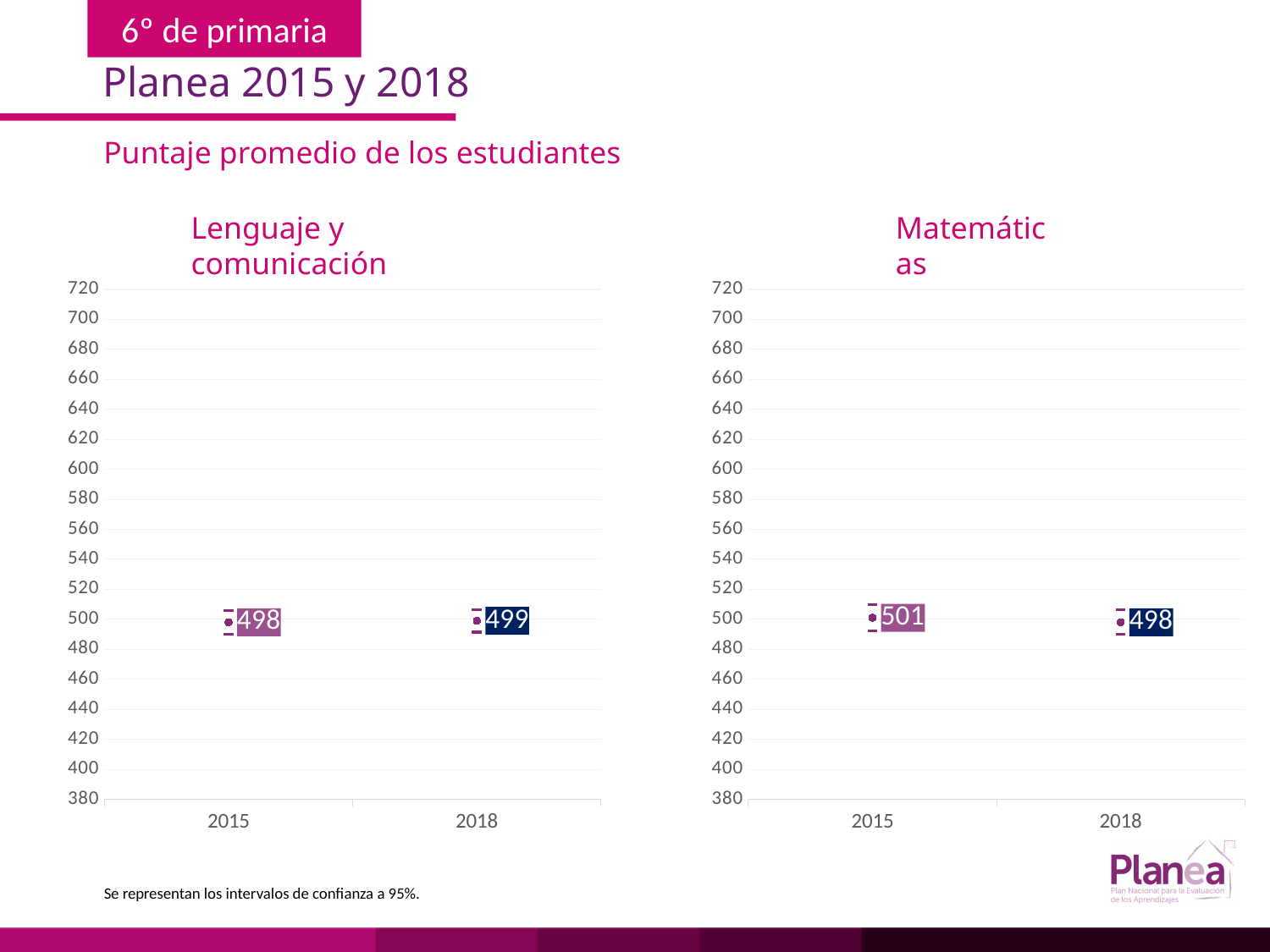
What is the title of the chart on the right side of the slide? Matemáticas In the 'Lenguaje y comunicación' chart, what is the difference between the 2018 and 2015 scores? 1 In the 'Matemáticas' chart, does the average score rise or fall from 2015 to 2018? fall In the 'Lenguaje y comunicación' chart, what is the average score for 2018? 499 In the 'Matemáticas' chart, which year has the higher average score? 2015 In the 'Matemáticas' chart, what is the difference between the 2015 and 2018 scores? 3 In the 'Lenguaje y comunicación' chart, which year has the lower average score? 2015 In the 'Matemáticas' chart, what is the average score for 2015? 501 In the 'Matemáticas' chart, what is the average score for 2018? 498 In the 'Matemáticas' chart, is the 2015 score greater or less than 500? greater In the 'Lenguaje y comunicación' chart, what is the average score for 2015? 498 How many years are plotted on the x axis of the 'Lenguaje y comunicación' chart? 2